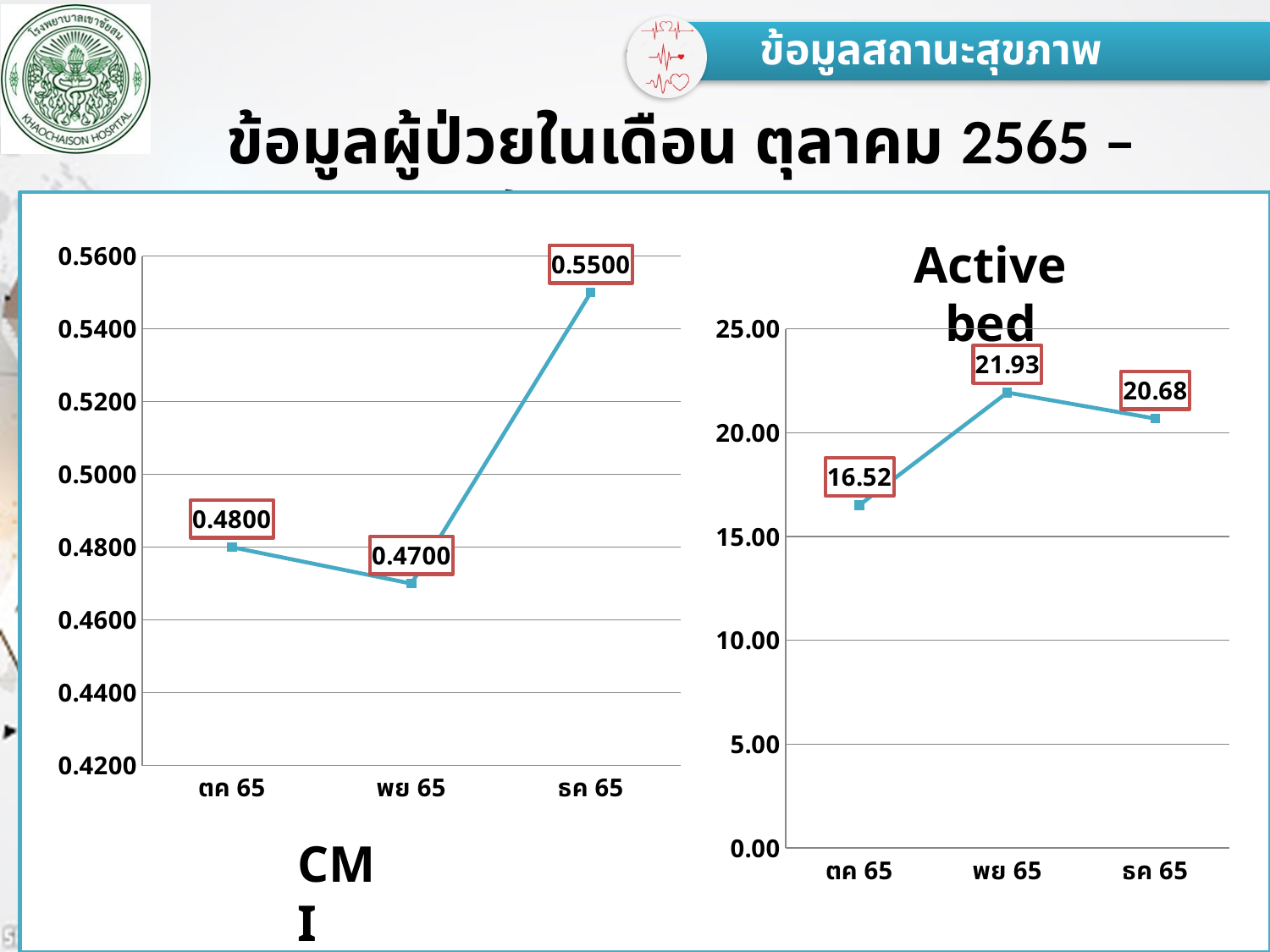
In the Active bed chart, is the value for ธค 65 greater or less than 20.00? greater In the CMI chart, what is the difference between the values for ธค 65 and พย 65? 0.0800 In the CMI chart, what is the value for ธค 65? 0.5500 In the Active bed chart, which month has the highest value? พย 65 In the CMI chart, how many data points are plotted? 3 In the CMI chart, which month has the lowest value? พย 65 In the Active bed chart, what is the value for พย 65? 21.93 In the Active bed chart, what is the difference between the values for พย 65 and ตค 65? 5.41 In the Active bed chart, what is the value for ตค 65? 16.52 In the CMI chart, what is the value for ตค 65? 0.4800 What kind of chart is the Active bed chart? line chart In the Active bed chart, which is larger, the value for ธค 65 or ตค 65? ธค 65